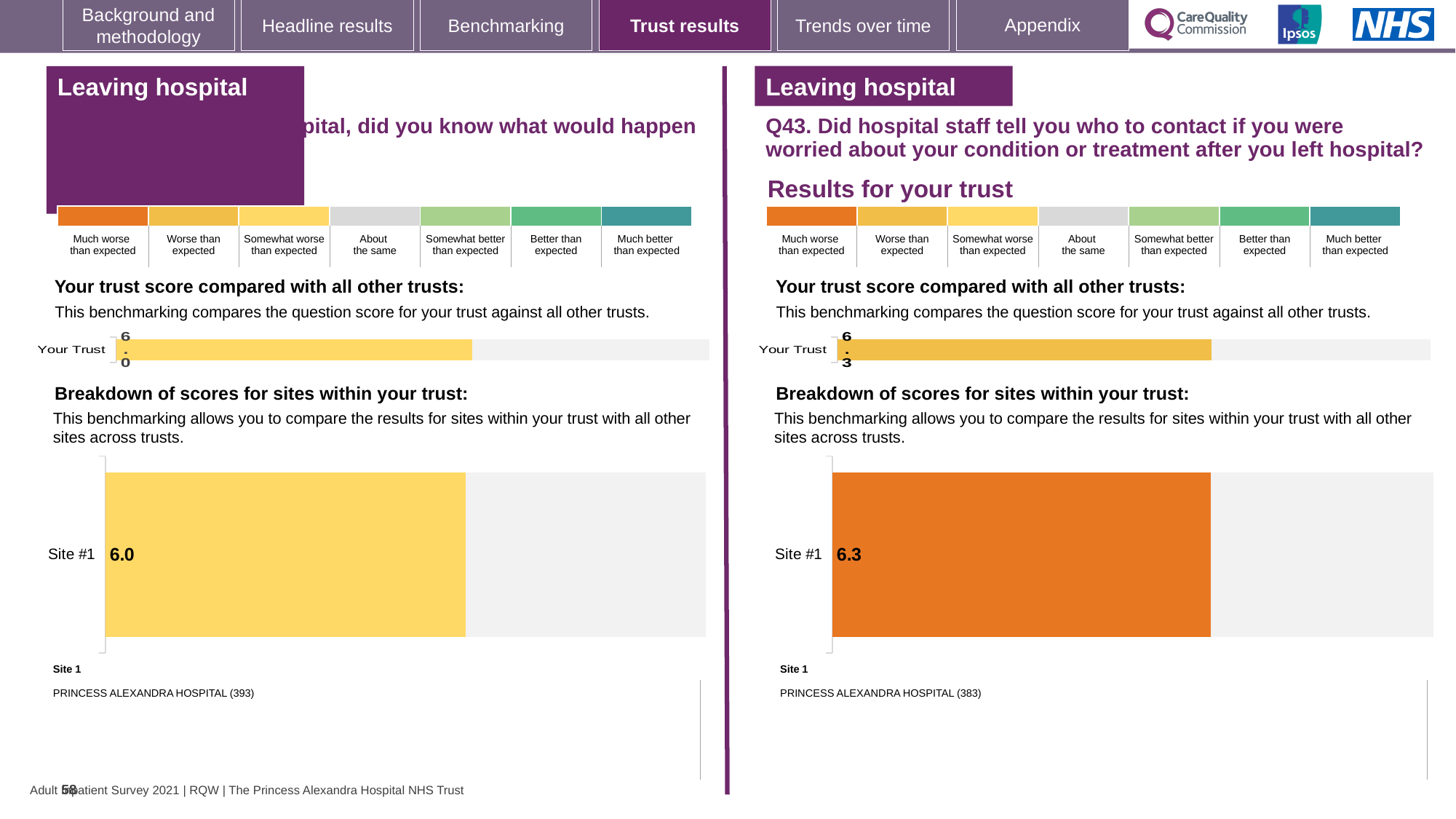
Comparing the Your Trust bars on the left-hand and right-hand trust score charts, which side shows the larger value? Right-hand (Q43) How many sites are shown on the left-hand 'Breakdown of scores for sites within your trust' chart? 1 What colour is the Site #1 bar on the left-hand site breakdown chart? Yellow On the left-hand 'Your trust score compared with all other trusts' chart, what is the value for Your Trust? 6.0 Comparing the Site #1 bars on the left-hand and right-hand site breakdown charts, which side shows the larger score? Right-hand (Q43) On the right-hand 'Breakdown of scores for sites within your trust' chart for Q43, what is the score for Site #1? 6.3 On the left-hand 'Breakdown of scores for sites within your trust' chart, what is the score for Site #1? 6.0 What kind of chart is used for the 'Breakdown of scores for sites within your trust' on the right-hand side? Bar chart On the right-hand 'Your trust score compared with all other trusts' chart for Q43, what is the value for Your Trust? 6.3 What is the difference between the Site #1 score on the right-hand chart (Q43) and the Site #1 score on the left-hand chart? 0.3 How many sites are shown on the right-hand 'Breakdown of scores for sites within your trust' chart for Q43? 1 What colour is the Site #1 bar on the right-hand site breakdown chart for Q43? Orange